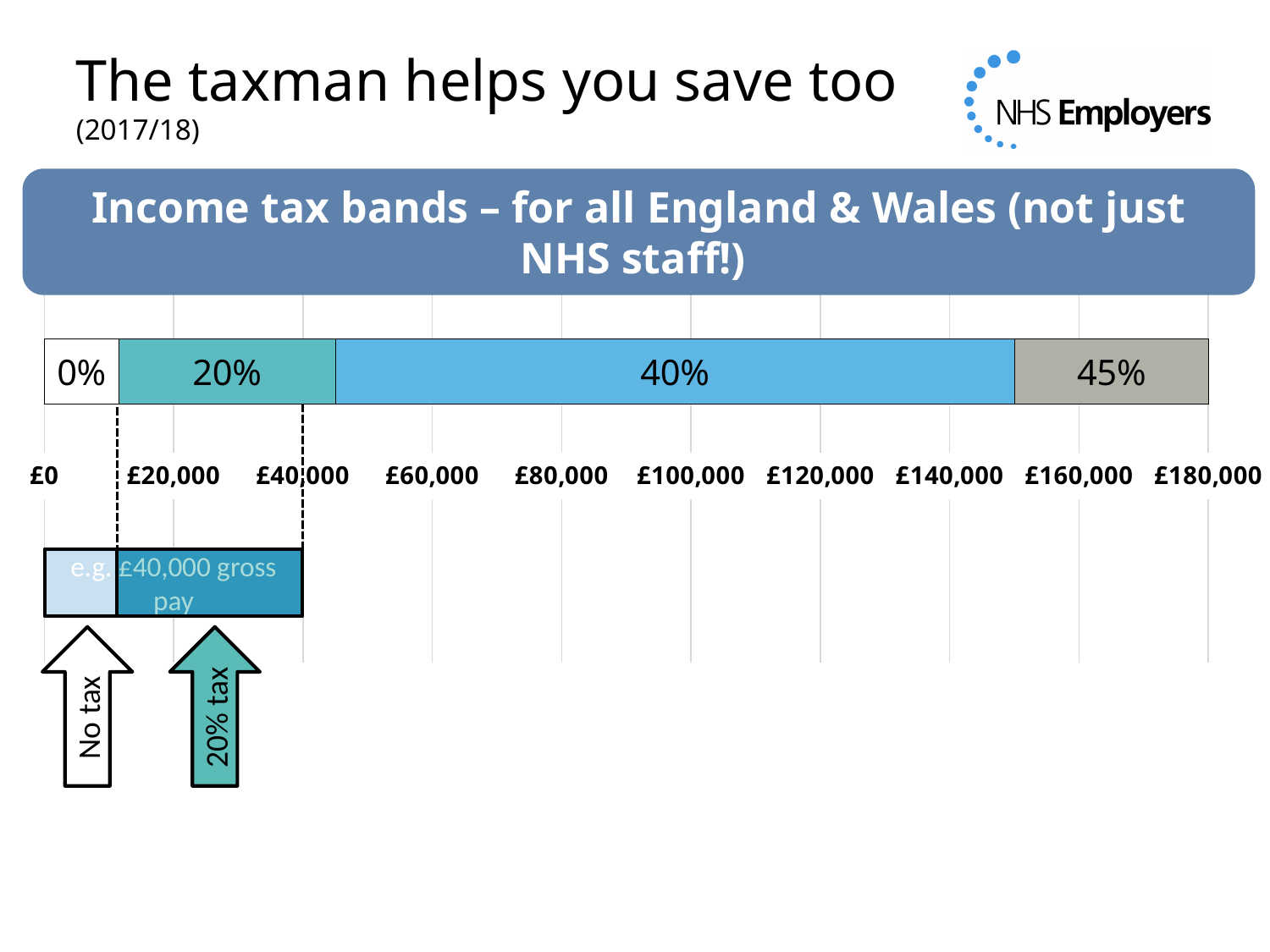
Does the 45% tax band start at an income greater or less than £120,000? greater What kind of chart is shown on the slide? bar chart Which tax band segment is the widest in the bar? 40% Which tax band segment is the narrowest in the bar? 0% How many income tax band segments are shown in the bar? 4 Does the 20% tax band end at an income greater or less than £60,000? less What gross pay is used in the example bar below the axis? £40,000 Does the 40% tax band extend to an income greater or less than £140,000? greater What is the highest value shown on the income axis? £180,000 What is the title of the chart? Income tax bands – for all England & Wales (not just NHS staff!) What is the highest tax rate label shown in the bar? 45% Which segment is wider, the 20% band or the 45% band? 20% band